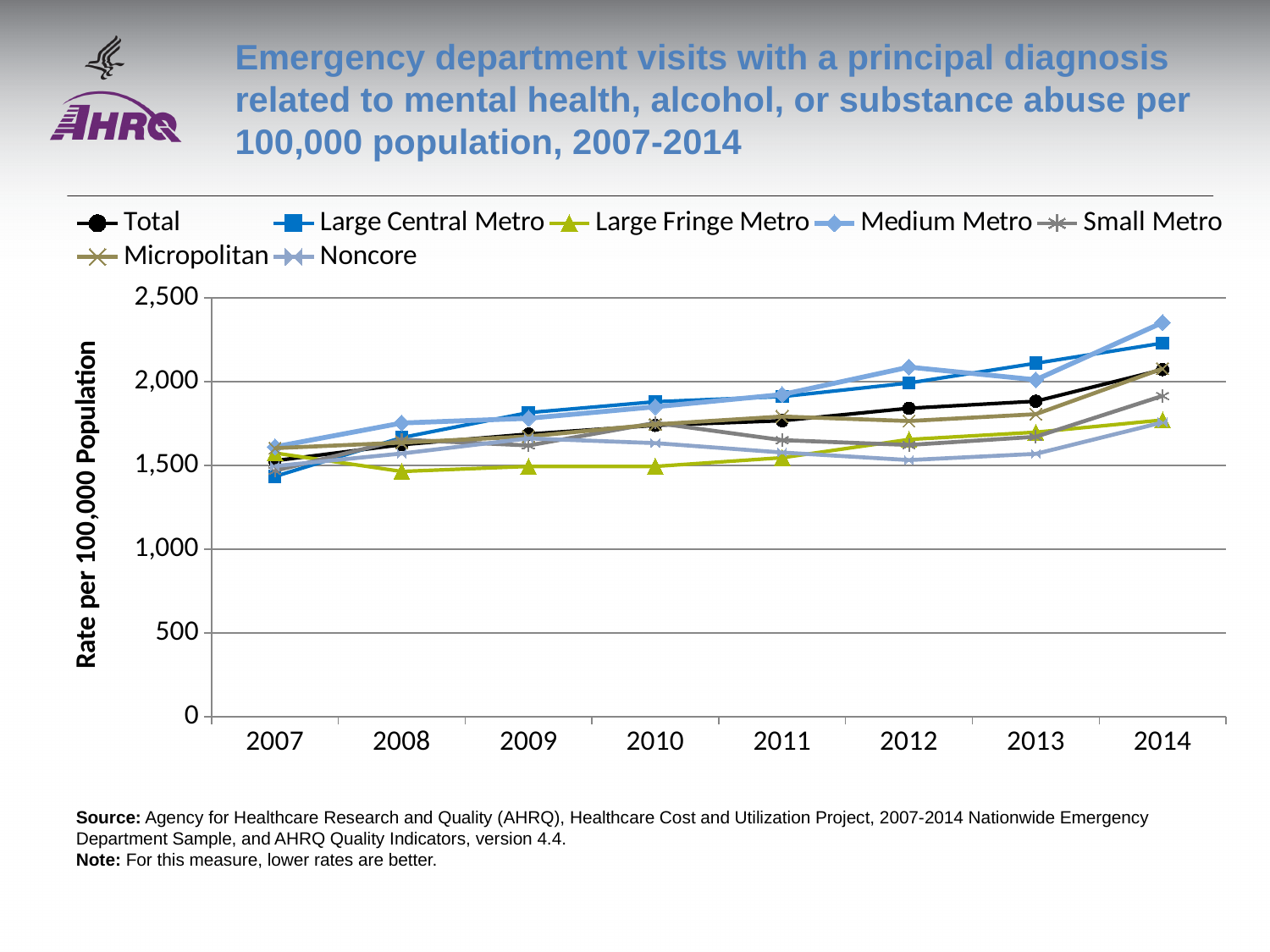
Is the value for Total in 2012 greater or less than 1,500? greater How many years are plotted along the x axis? 8 Is the value for Medium Metro in 2014 greater or less than 2,000? greater What is the title of the y axis? Rate per 100,000 Population Does the Large Central Metro series rise or fall from 2007 to 2014? rise How many series does the legend list? 7 What kind of chart is shown on the slide? Line chart In 2012, which is larger: the value for Medium Metro or the value for Large Fringe Metro? Medium Metro Is the value for Large Central Metro in 2007 greater or less than 1,500? less Which series has the highest value in 2014? Medium Metro Which series has the lowest value in 2010? Large Fringe Metro